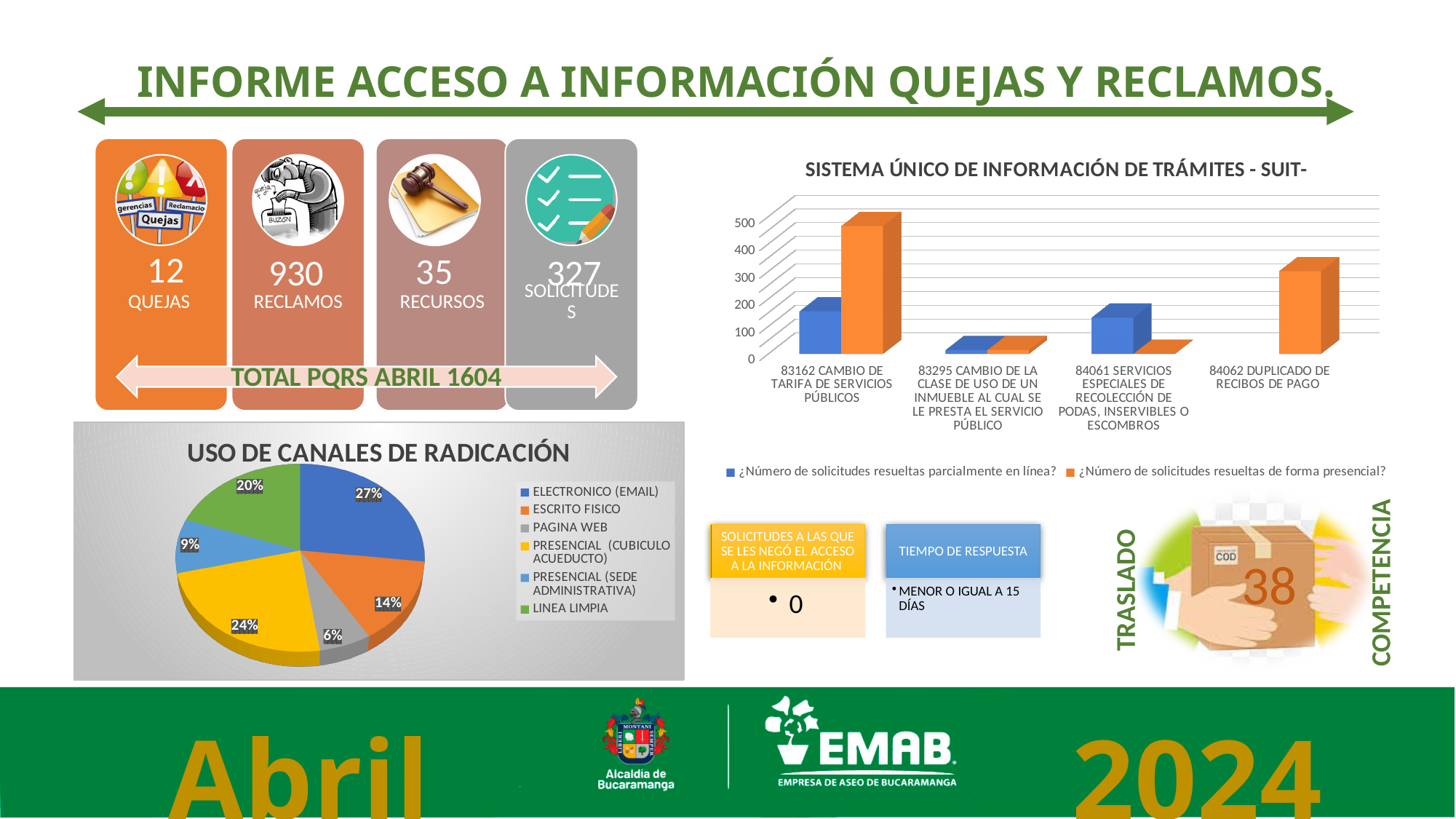
In the pie chart 'USO DE CANALES DE RADICACIÓN', which channel has the smallest share? PAGINA WEB In the chart 'SISTEMA ÚNICO DE INFORMACIÓN DE TRÁMITES - SUIT-', how many series does the legend list? 2 In the pie chart 'USO DE CANALES DE RADICACIÓN', how many channels are shown? 6 In the pie chart 'USO DE CANALES DE RADICACIÓN', what share does PRESENCIAL (CUBICULO ACUEDUCTO) have? 24% In the chart 'SISTEMA ÚNICO DE INFORMACIÓN DE TRÁMITES - SUIT-', which category has the highest value for solicitudes resueltas de forma presencial? 83162 CAMBIO DE TARIFA DE SERVICIOS PÚBLICOS What kind of chart is 'SISTEMA ÚNICO DE INFORMACIÓN DE TRÁMITES - SUIT-'? Bar chart In the chart 'SISTEMA ÚNICO DE INFORMACIÓN DE TRÁMITES - SUIT-', is the value of solicitudes resueltas de forma presencial for '83162 CAMBIO DE TARIFA DE SERVICIOS PÚBLICOS' greater or less than 400? greater In the pie chart 'USO DE CANALES DE RADICACIÓN', which channel has the largest share? ELECTRONICO (EMAIL) In the pie chart 'USO DE CANALES DE RADICACIÓN', which is larger: PRESENCIAL (SEDE ADMINISTRATIVA) or ESCRITO FISICO? ESCRITO FISICO In the pie chart 'USO DE CANALES DE RADICACIÓN', what share does ELECTRONICO (EMAIL) have? 27% In the pie chart 'USO DE CANALES DE RADICACIÓN', what share does PAGINA WEB have? 6% In the pie chart 'USO DE CANALES DE RADICACIÓN', what is the difference between the shares of LINEA LIMPIA and ESCRITO FISICO? 6%